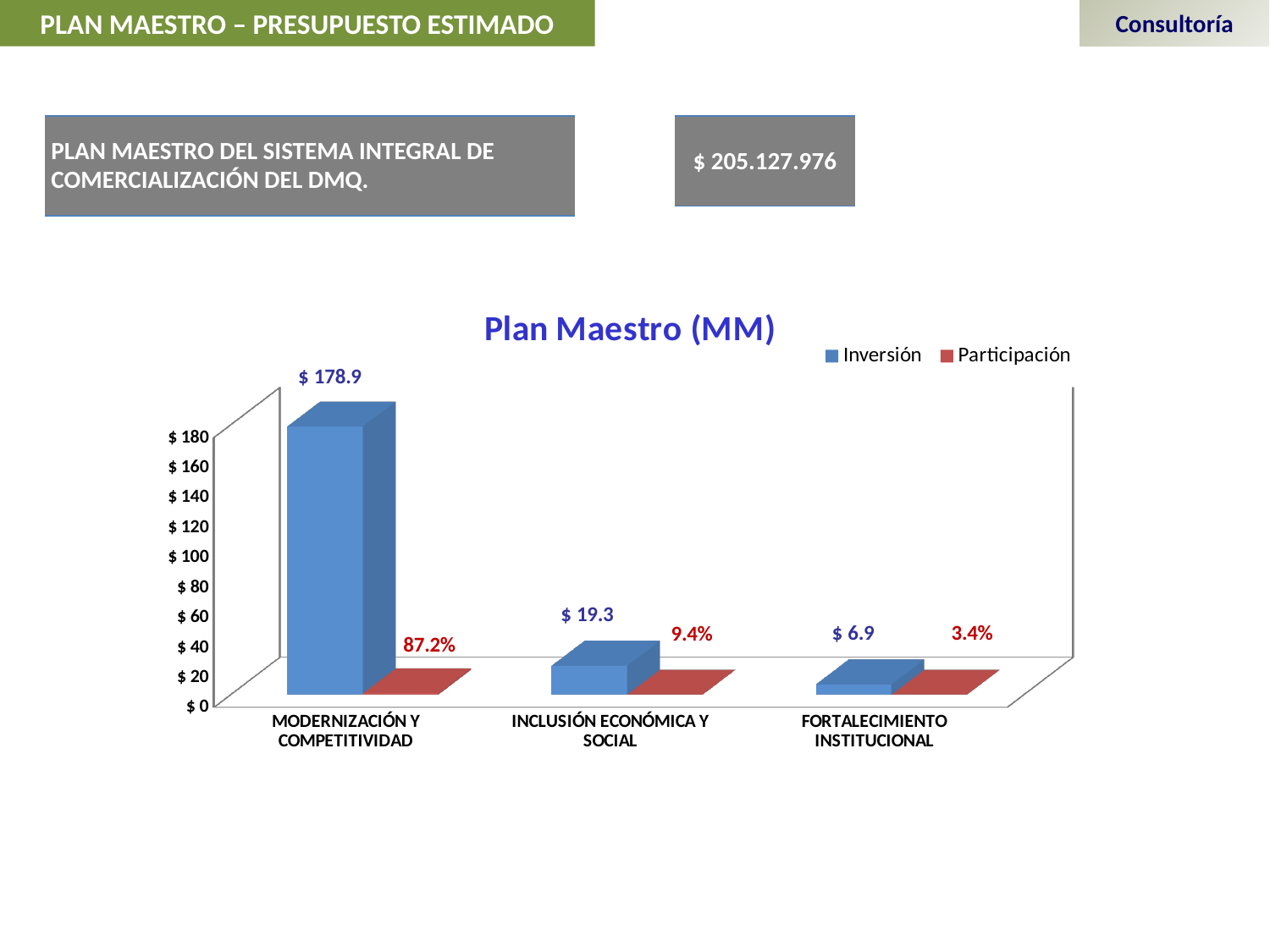
Which category has the highest Inversión value? MODERNIZACIÓN Y COMPETITIVIDAD What is the Participación value for FORTALECIMIENTO INSTITUCIONAL? 3.4% What is the difference in Inversión between MODERNIZACIÓN Y COMPETITIVIDAD and INCLUSIÓN ECONÓMICA Y SOCIAL? $ 159.6 What type of chart is shown on the slide? Bar chart What is the Inversión value for FORTALECIMIENTO INSTITUCIONAL? $ 6.9 Which category has the lowest Participación value? FORTALECIMIENTO INSTITUCIONAL What is the Participación value for INCLUSIÓN ECONÓMICA Y SOCIAL? 9.4% What is the Inversión value for MODERNIZACIÓN Y COMPETITIVIDAD? $ 178.9 How many categories are shown on the x axis of the chart? 3 How many series does the chart legend list? 2 Which has a larger Inversión value, INCLUSIÓN ECONÓMICA Y SOCIAL or FORTALECIMIENTO INSTITUCIONAL? INCLUSIÓN ECONÓMICA Y SOCIAL What is the Inversión value for INCLUSIÓN ECONÓMICA Y SOCIAL? $ 19.3